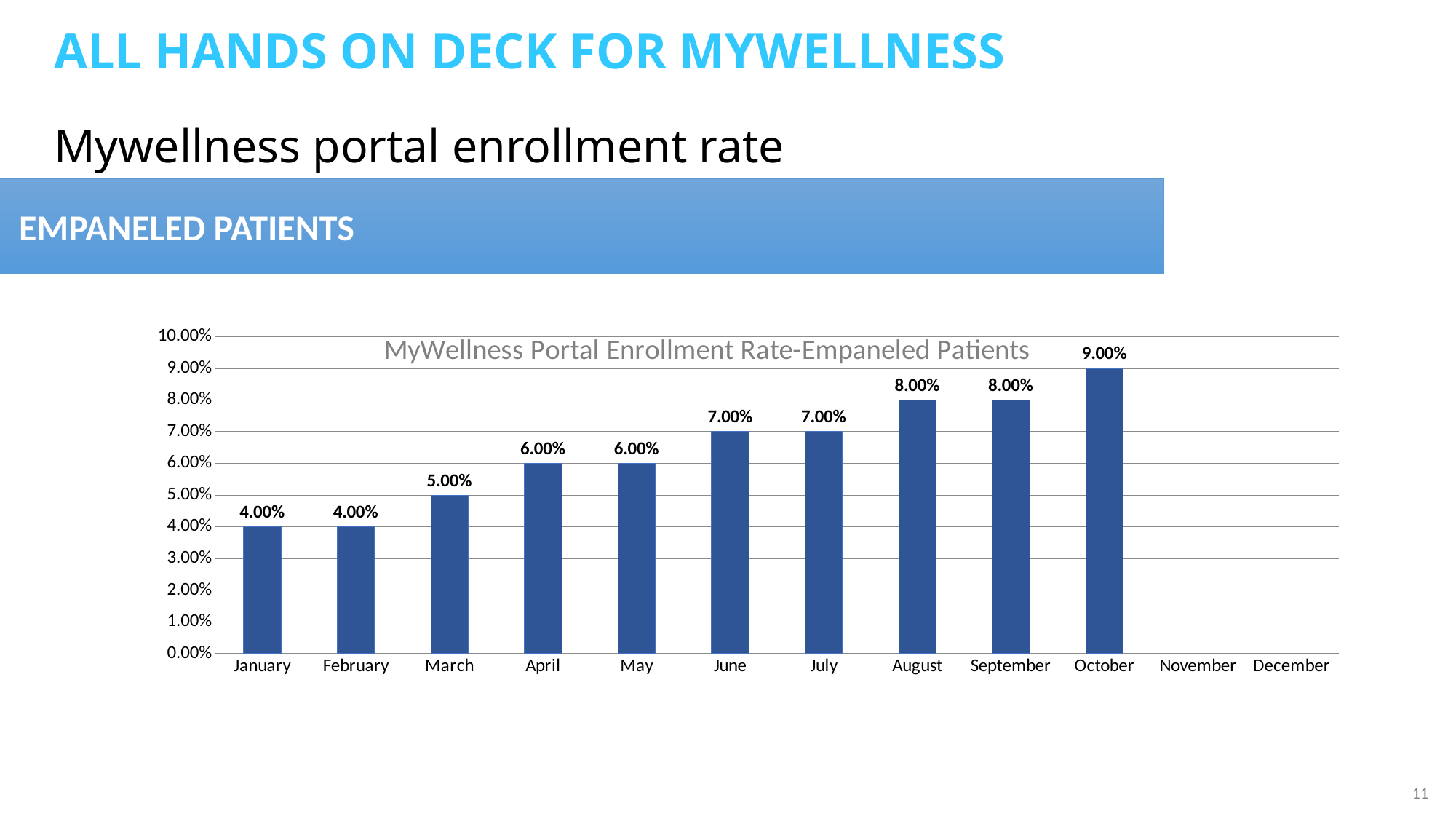
What is the enrollment rate for March? 5.00% What is the difference between the enrollment rates for October and January? 5.00% Which is larger, the enrollment rate for June or the enrollment rate for February? June How many months have a bar plotted on the chart? 10 What is the enrollment rate for January? 4.00% Which month has the highest enrollment rate? October What is the enrollment rate for October? 9.00% What kind of chart is shown on the slide? Bar chart Is the value for September greater or less than 5.00%? greater How many months are labeled on the x axis? 12 What is the difference between the enrollment rates for August and April? 2.00% Do the enrollment rates generally rise or fall from January to October? Rise